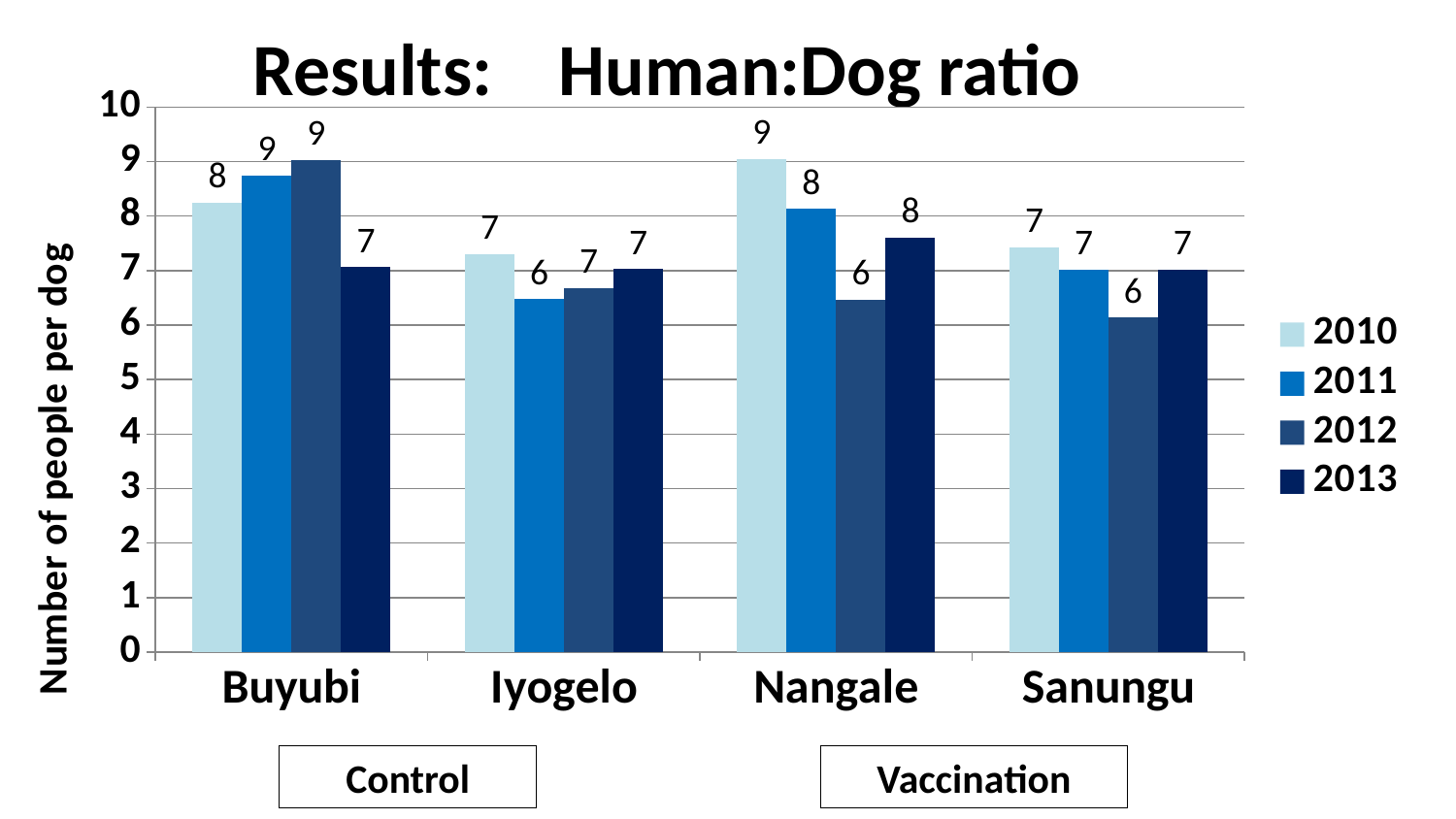
What is the value for Buyubi in 2013? 7 What is the value for Sanungu in 2012? 6 What is the difference between the 2012 and 2013 values for Buyubi? 2 What is the value for Nangale in 2010? 9 Which year has the lowest value for Buyubi? 2013 How many series does the legend list? 4 What kind of chart is shown? bar chart Is the value for Iyogelo in 2011 greater or less than 7? less Which is larger, the 2010 value for Buyubi or the 2010 value for Nangale? Nangale How many villages are shown on the x axis? 4 Which year has the highest value for Nangale? 2010 Which two villages are labelled as the Control group? Buyubi and Iyogelo